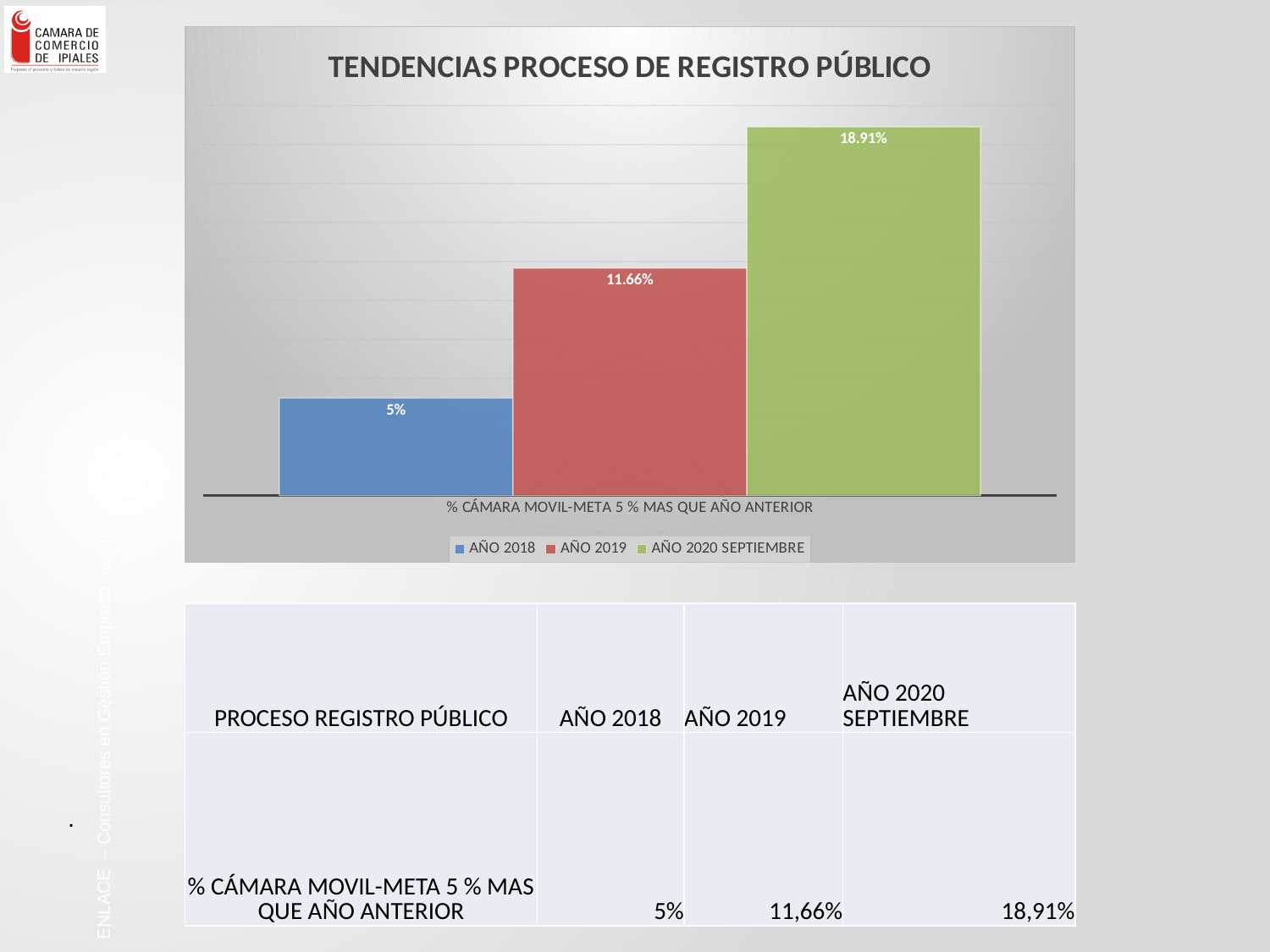
What kind of chart is shown on the slide? Bar chart How many series does the legend list? 3 What is the title of the chart? TENDENCIAS PROCESO DE REGISTRO PÚBLICO What is the value for AÑO 2019 in the chart? 11.66% What is the difference between the values for AÑO 2020 SEPTIEMBRE and AÑO 2019? 7.25% Do the values rise or fall from AÑO 2018 to AÑO 2020 SEPTIEMBRE? Rise Which series has the lowest value in the chart? AÑO 2018 Which is larger, the value for AÑO 2019 or the value for AÑO 2018? AÑO 2019 What is the value for AÑO 2018 in the chart? 5% Which series has the highest value in the chart? AÑO 2020 SEPTIEMBRE What is the value for AÑO 2020 SEPTIEMBRE in the chart? 18.91% What is the difference between the values for AÑO 2019 and AÑO 2018? 6.66%